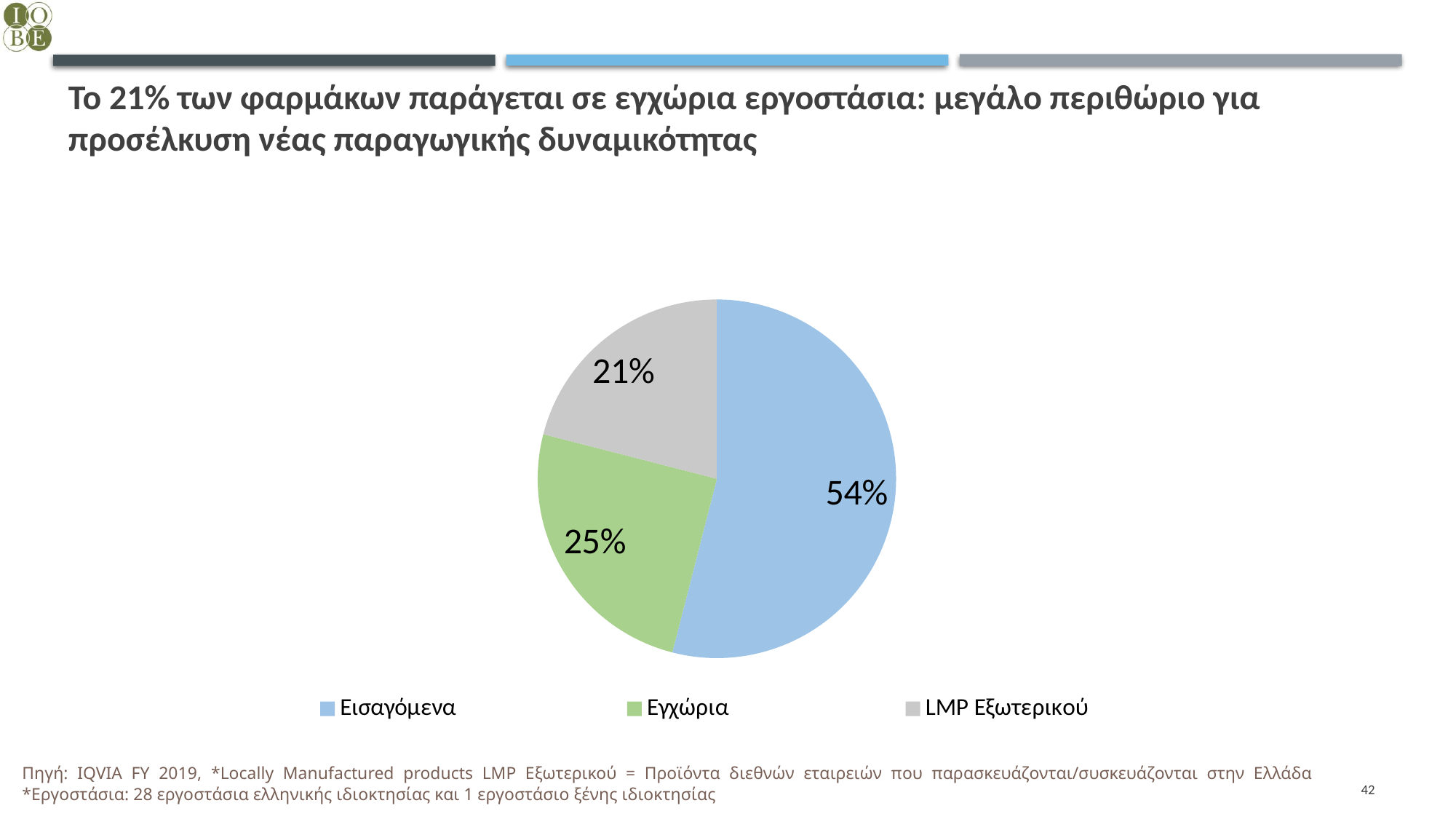
How many slices does the pie chart have? 3 Which is larger, the share for Εγχώρια or the share for LMP Εξωτερικού? Εγχώρια What share of the pie does Εισαγόμενα hold? 54% Which category has the smallest slice of the pie? LMP Εξωτερικού Which category has the largest slice of the pie? Εισαγόμενα What colour is the slice for Εγχώρια? green What is the difference in percentage points between Εισαγόμενα and Εγχώρια? 29 What share of the pie does Εγχώρια hold? 25% What kind of chart is shown on the slide? pie chart What is the difference in percentage points between Εγχώρια and LMP Εξωτερικού? 4 What share of the pie does LMP Εξωτερικού hold? 21% How many entries does the legend list? 3